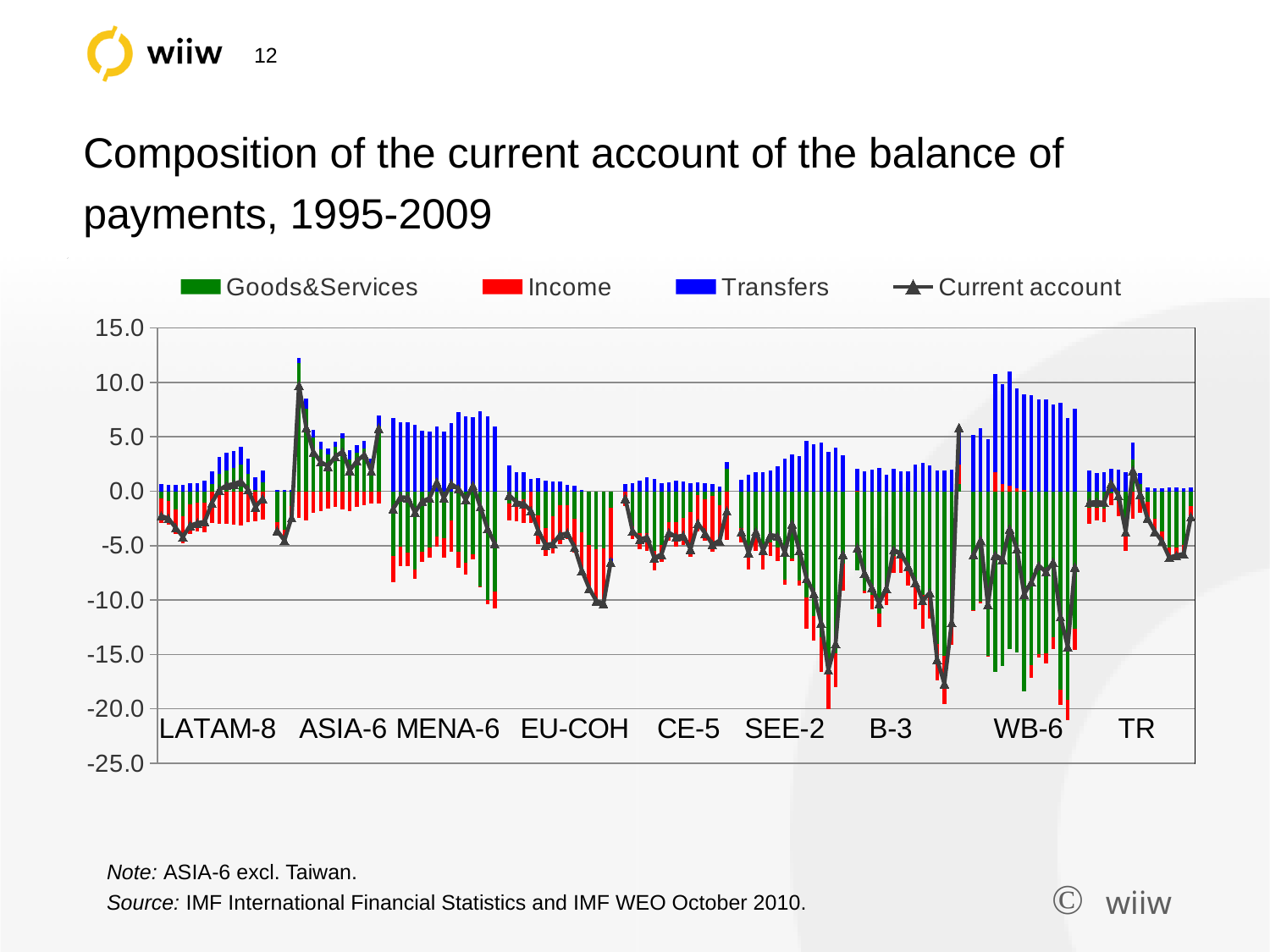
What colour represents the Income series? red Is the highest Transfers bar in the WB-6 group greater or less than 5.0? greater Is the highest Current account value in the ASIA-6 group greater or less than 5.0? greater How many series does the legend list? 4 Which group reaches a higher Current account peak, ASIA-6 or CE-5? ASIA-6 What kind of chart is shown on the slide? combination bar and line chart How many region groups are labeled along the x axis? 9 Which group reaches a deeper Current account trough, SEE-2 or LATAM-8? SEE-2 Which series is plotted as a line with triangle markers rather than as bars? Current account Is the lowest Current account value in the SEE-2 group greater or less than -10.0? less